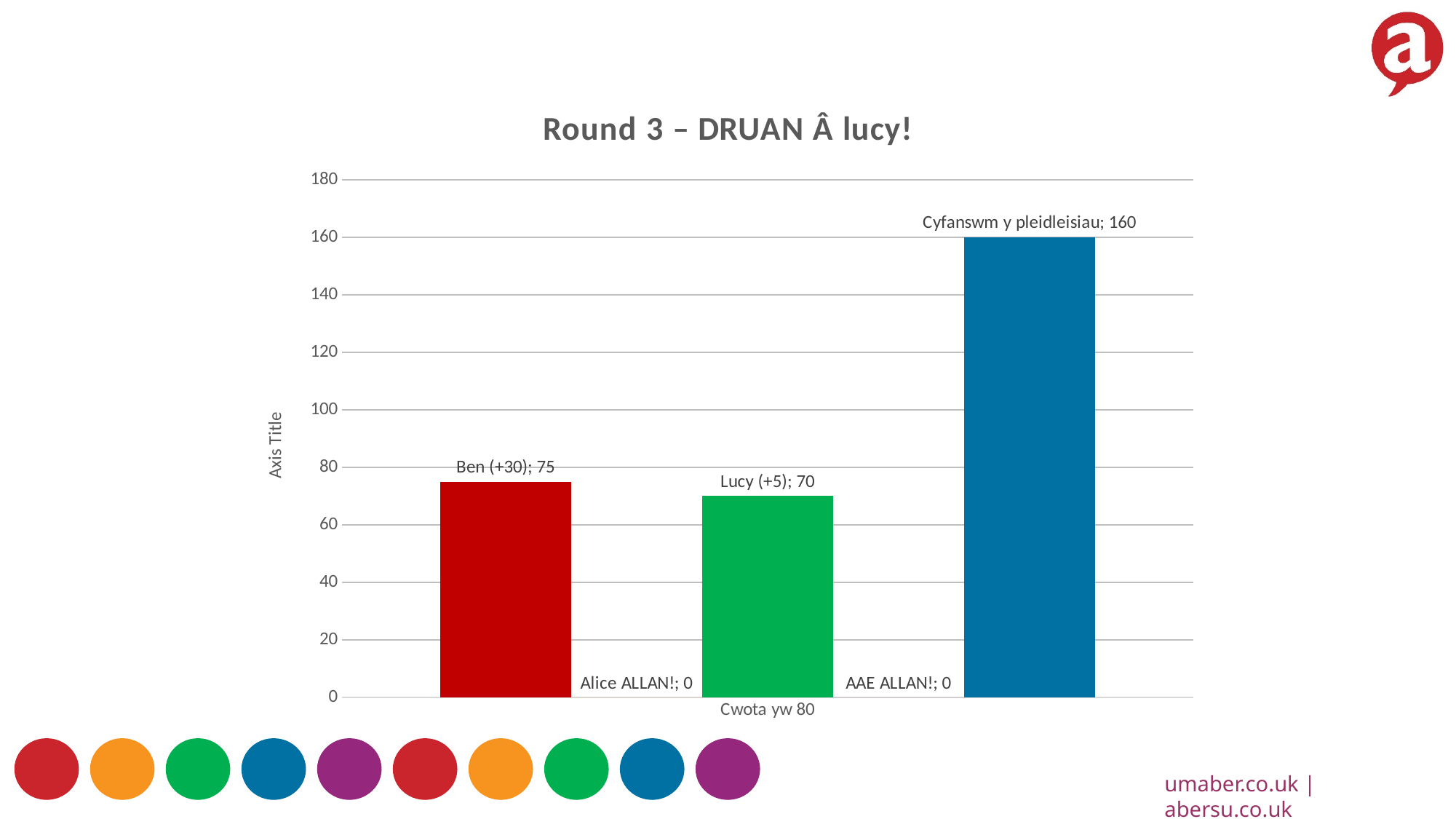
What is the difference between the values for Cyfanswm y pleidleisiau and Ben (+30)? 85 What is the title of the chart? Round 3 – DRUAN Â lucy! Which is larger, the value for Ben (+30) or the value for Lucy (+5)? Ben (+30) How many categories are labelled on the chart? 5 What text appears as the horizontal axis label below the bars? Cwota yw 80 What is the value for Cyfanswm y pleidleisiau? 160 What is the difference between the values for Ben (+30) and Lucy (+5)? 5 What is the value for Alice ALLAN!? 0 What is the value for Lucy (+5)? 70 Which category has the highest value? Cyfanswm y pleidleisiau What is the value for Ben (+30)? 75 What kind of chart is shown on the slide? Bar chart